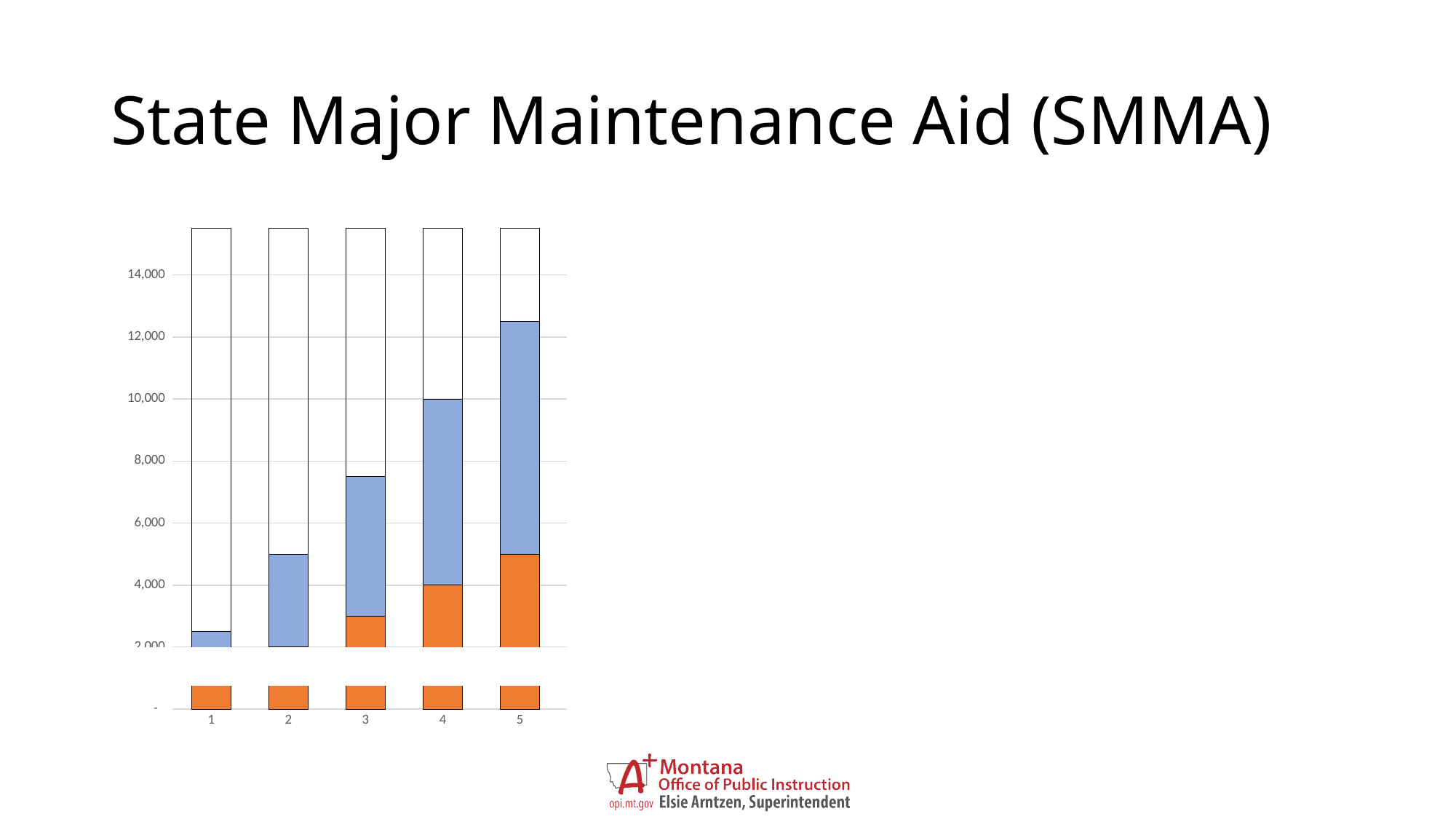
Is the top of the blue segment for category 2 greater or less than 6,000? less What kind of chart is shown on the slide? bar chart Which category has the tallest orange segment? 5 Is the top of the blue segment for category 3 greater or less than 8,000? less What is the title of the slide containing the chart? State Major Maintenance Aid (SMMA) Is the top of the orange segment for category 5 greater or less than 4,000? greater Do the tops of the blue segments rise or fall from category 1 to category 5? rise Which category has the lowest top of the blue segment? 1 How many categories are shown along the x axis of the chart? 5 What value does the top of the orange segment reach for category 4? 4,000 What value does the top of the blue segment reach for category 4? 10,000